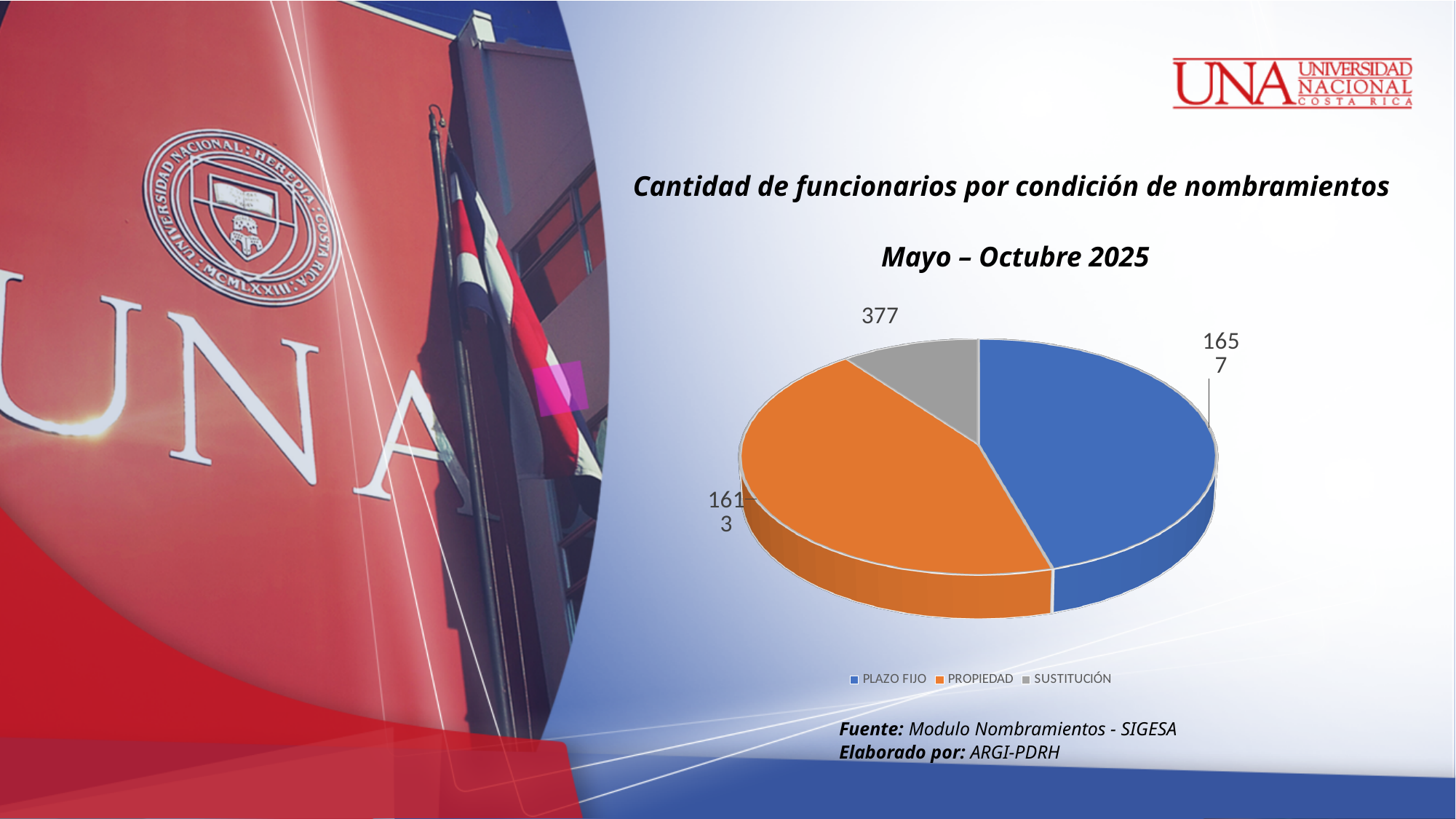
What is the value for PLAZO FIJO? 1657 What is the value for PROPIEDAD? 1613 What is the title of the chart? Cantidad de funcionarios por condición de nombramientos Mayo – Octubre 2025 What is the value for SUSTITUCIÓN? 377 Which category has the largest slice? PLAZO FIJO How many categories does the pie chart show? 3 What kind of chart is shown on the slide? Pie chart Which category has the smallest slice? SUSTITUCIÓN What is the difference between the values for PROPIEDAD and SUSTITUCIÓN? 1236 What is the difference between the values for PLAZO FIJO and PROPIEDAD? 44 Which colour represents PROPIEDAD in the legend? Orange Which is larger, the value for PROPIEDAD or the value for SUSTITUCIÓN? PROPIEDAD